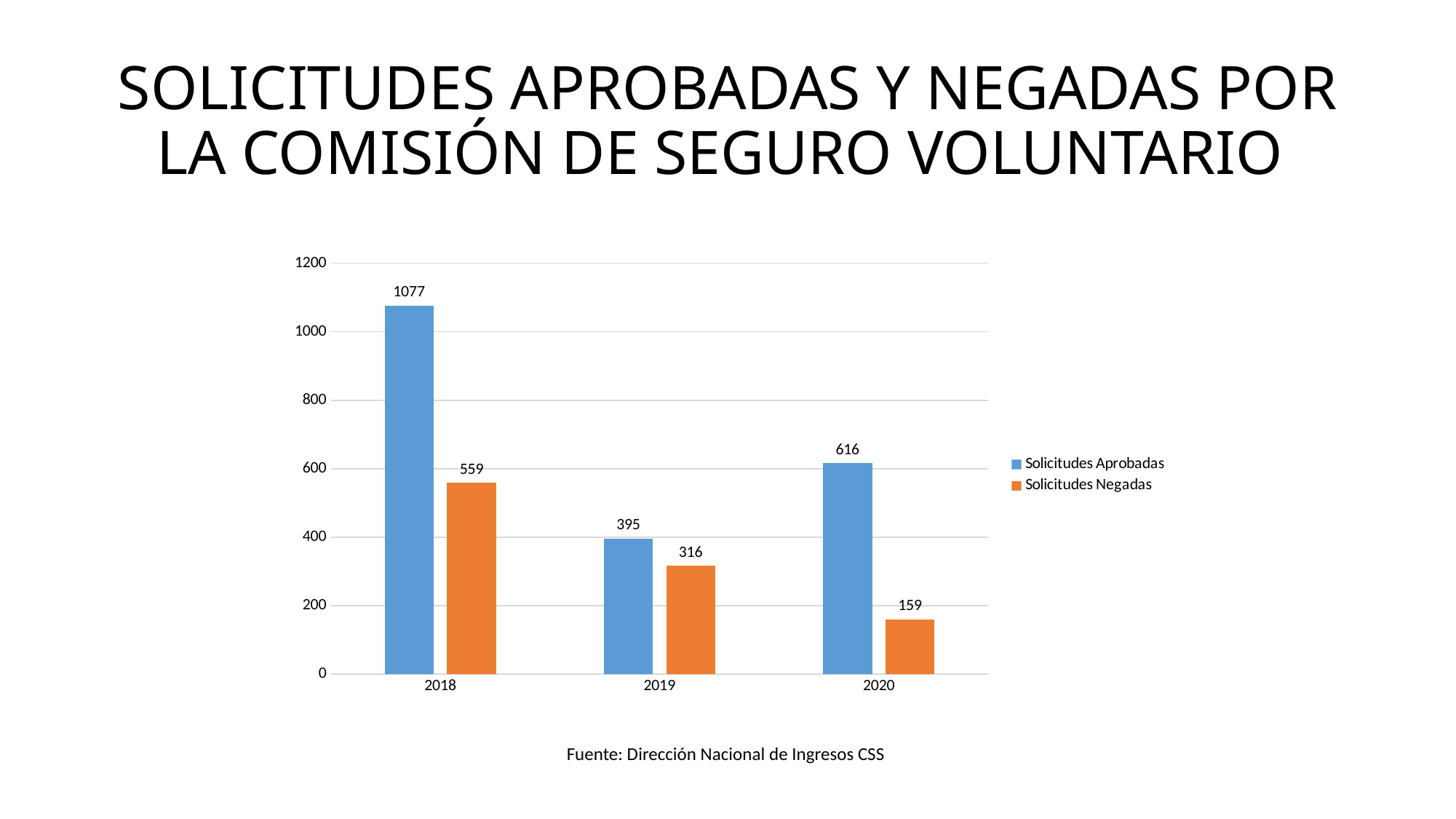
What kind of chart is shown on the slide? bar chart What is the value of Solicitudes Aprobadas for 2018? 1077 How many years are shown on the x axis? 3 Which year has the lowest value for Solicitudes Negadas? 2020 What colour represents Solicitudes Negadas in the chart? orange How many series does the legend list? 2 What is the difference between Solicitudes Aprobadas and Solicitudes Negadas in 2018? 518 Is the value for Solicitudes Aprobadas in 2019 greater or less than 400? less What is the value of Solicitudes Negadas for 2020? 159 What is the value of Solicitudes Negadas for 2019? 316 Which year has the highest value for Solicitudes Aprobadas? 2018 Which is larger in 2020: Solicitudes Aprobadas or Solicitudes Negadas? Solicitudes Aprobadas